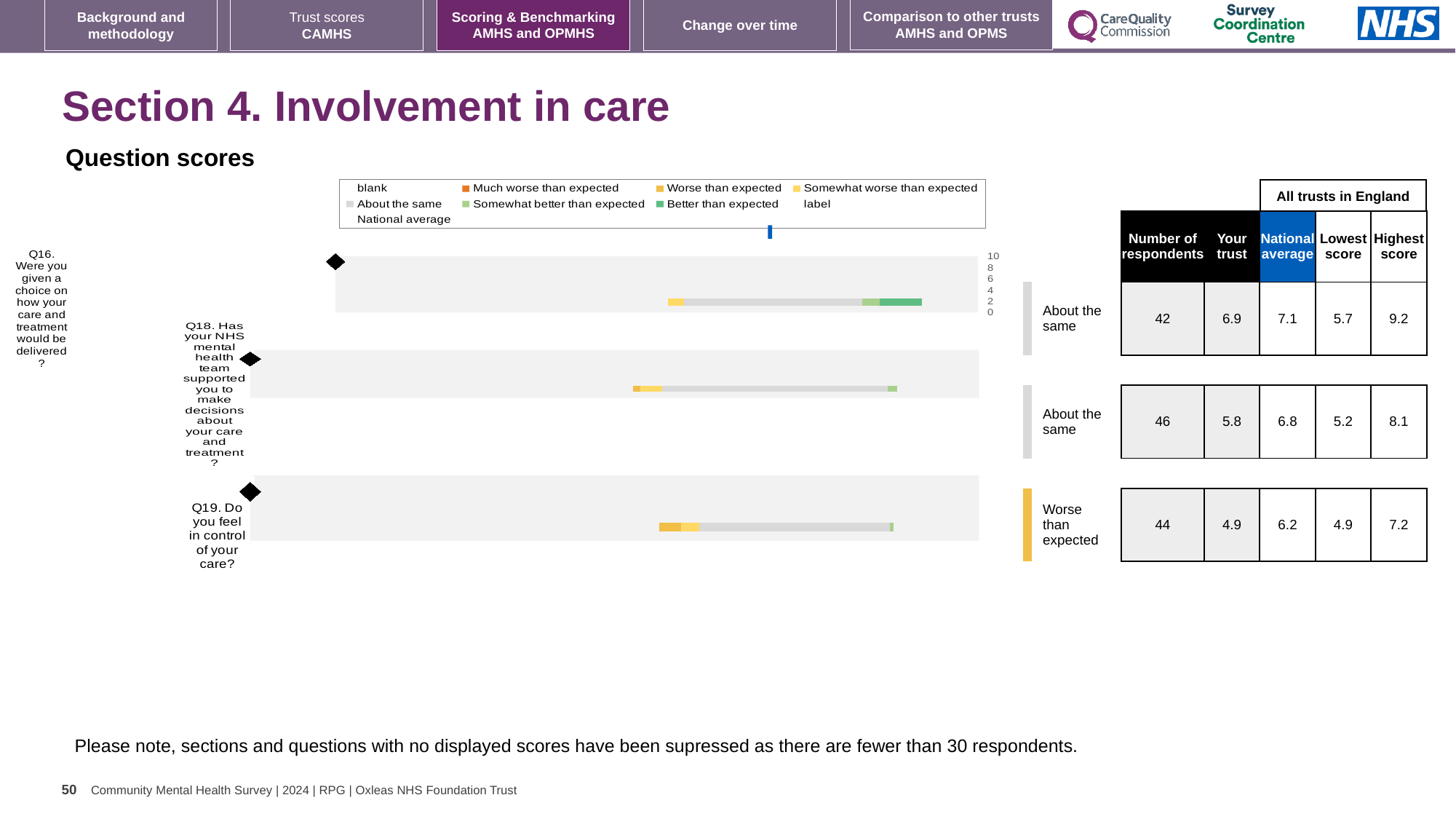
Which has the larger 'Your trust' score, Q18 or Q19? Q18 Which question has the highest 'Your trust' score? Q16 What rating label is shown next to the bar for Q19 (Do you feel in control of your care?)? Worse than expected What kind of chart is used to show the question scores on this slide? bar chart What is the difference between the national average and the 'Your trust' score for Q19? 1.3 How many respondents answered Q18? 46 What is the national average score for Q18 (Has your NHS mental health team supported you to make decisions about your care and treatment?)? 6.8 Which question has the lowest 'Your trust' score? Q19 How many entries does the legend of the question scores chart list? 9 How many questions (categories) are plotted in the question scores chart? 3 What is the highest score among all trusts in England for Q19 (Do you feel in control of your care?)? 7.2 What is the 'Your trust' score for Q16 (Were you given a choice on how your care and treatment would be delivered?)? 6.9